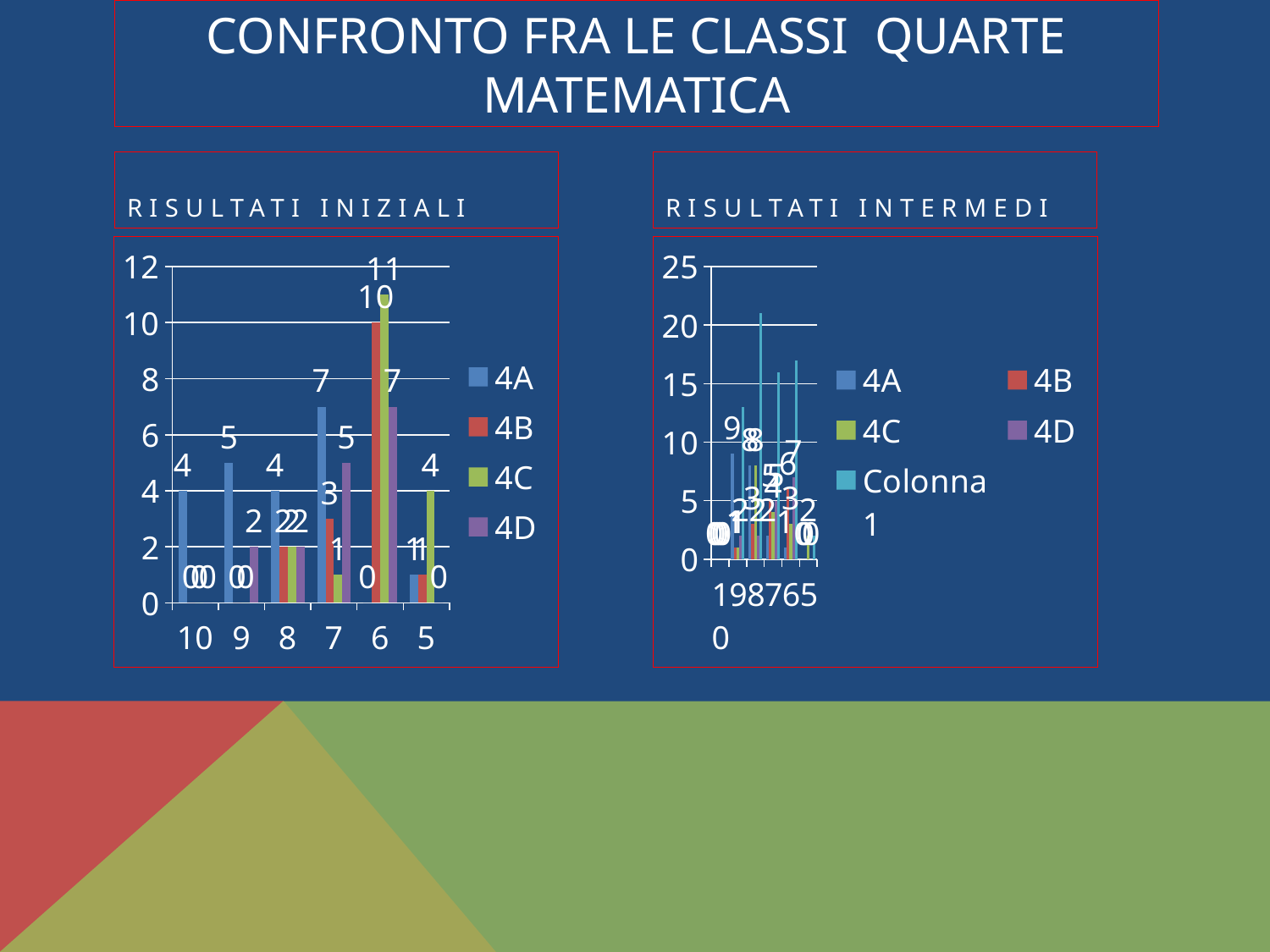
What kind of chart is the RISULTATI INTERMEDI chart? Bar chart In the RISULTATI INIZIALI chart, what is the value for 4B at category 6? 10 In the RISULTATI INIZIALI chart, what is the value for 4D at category 7? 5 In the RISULTATI INIZIALI chart, how many categories are shown on the x axis? 6 In the RISULTATI INIZIALI chart, what is the value for 4A at category 10? 4 In the RISULTATI INIZIALI chart, what is the value for 4C at category 6? 11 In the RISULTATI INIZIALI chart, which category has the highest value for 4A? 7 In the RISULTATI INIZIALI chart, what is the difference between the 4C and 4B values at category 6? 1 In the RISULTATI INIZIALI chart, how many series does the legend list? 4 In the RISULTATI INIZIALI chart, which series has the highest value at category 6? 4C In the RISULTATI INIZIALI chart, which is larger at category 9: the value for 4A or the value for 4D? 4A In the RISULTATI INTERMEDI chart, how many series does the legend list? 5